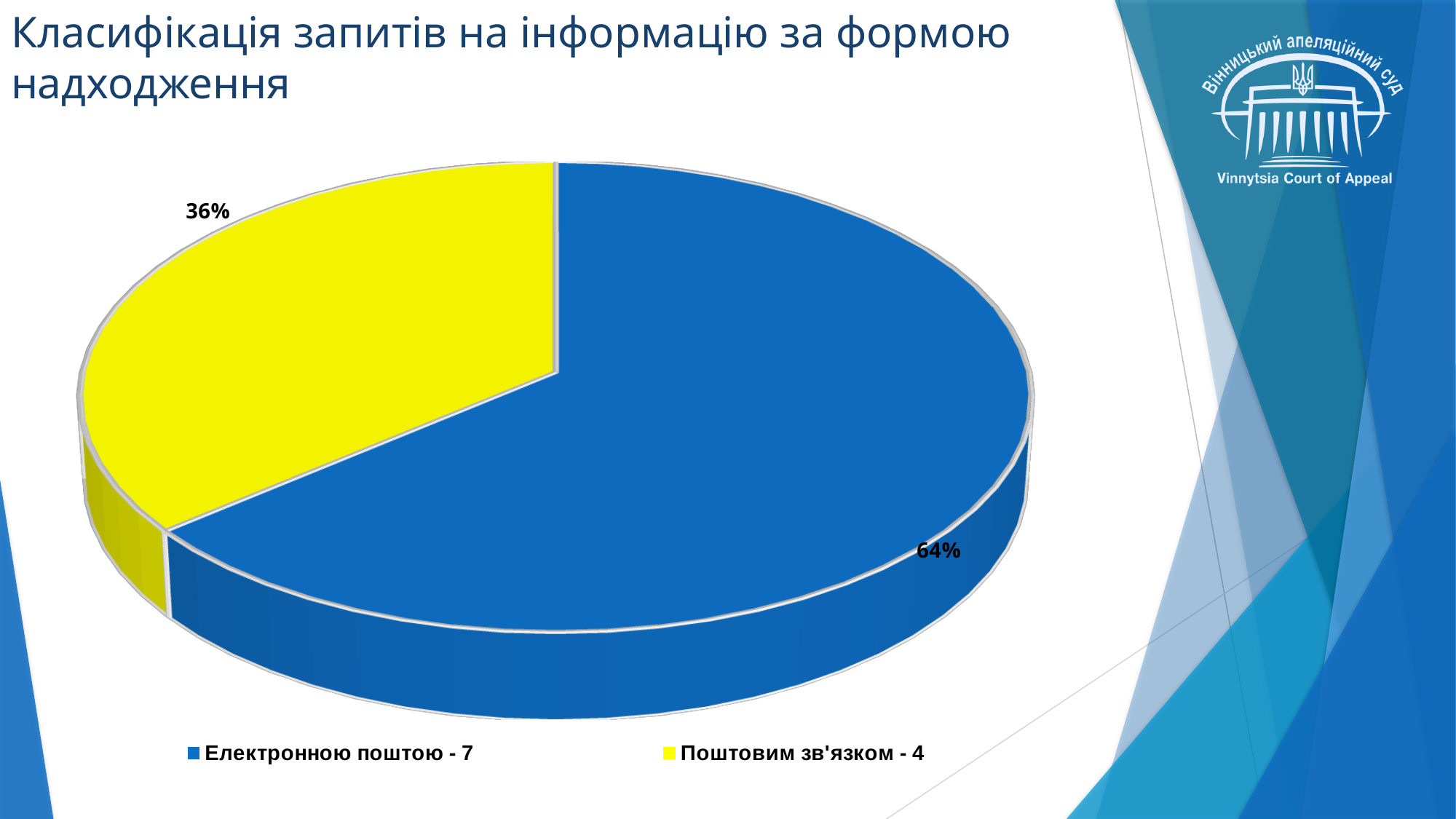
What percentage share does the 'Поштовим зв'язком - 4' slice have? 36% What colour is the 'Поштовим зв'язком - 4' slice? yellow What is the difference in percentage points between the 'Електронною поштою' slice and the 'Поштовим зв'язком' slice? 28% How many entries does the legend list? 2 How many requests were received by e-mail according to the legend? 7 How many slices does the pie chart have? 2 What is the title of the slide containing the chart? Класифікація запитів на інформацію за формою надходження What kind of chart is shown on the slide? pie chart What percentage share does the 'Електронною поштою - 7' slice have? 64% Which slice is larger: 'Електронною поштою' or 'Поштовим зв'язком'? Електронною поштою Which category has the largest slice of the pie? Електронною поштою - 7 Which category has the smallest slice of the pie? Поштовим зв'язком - 4